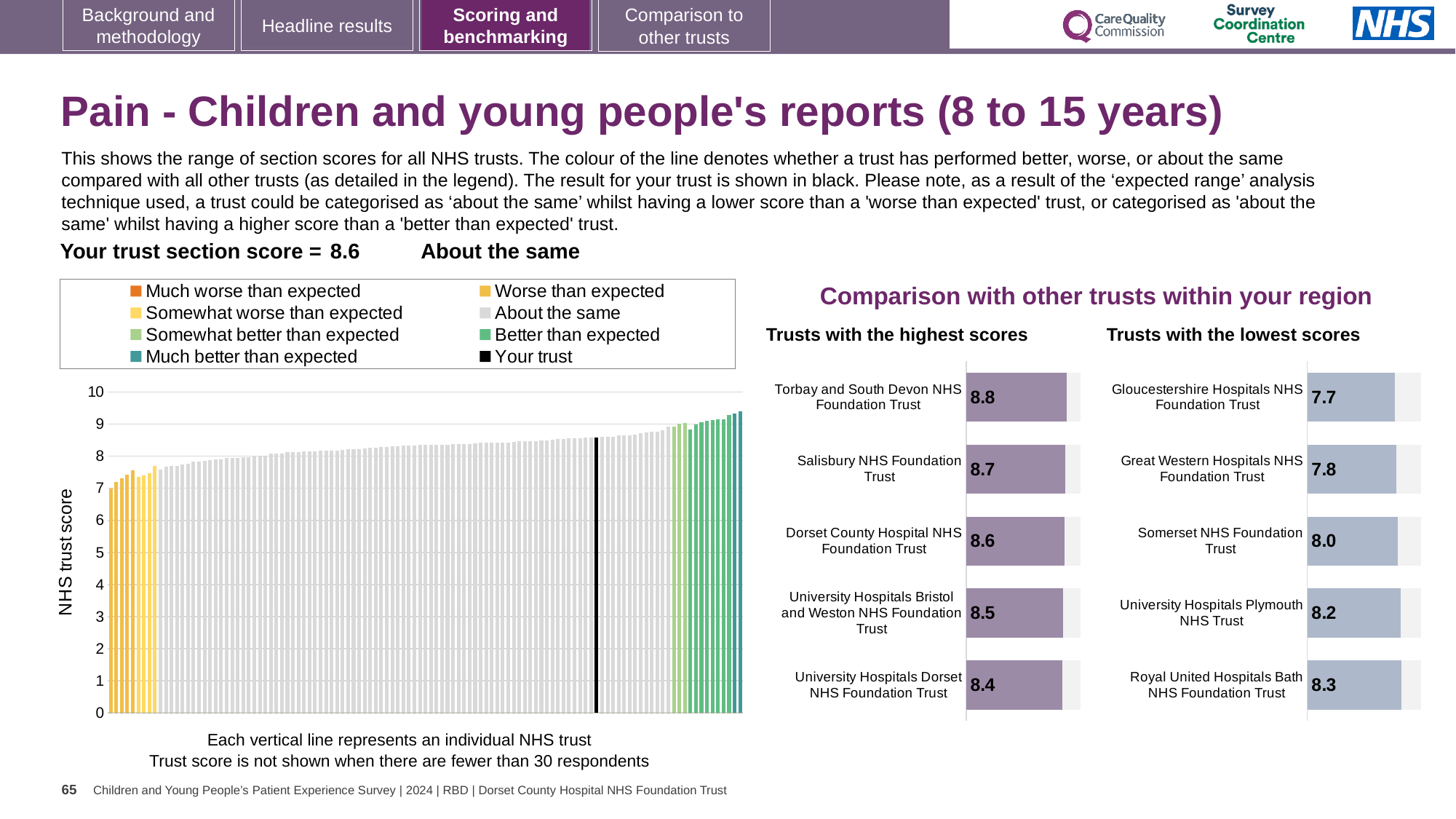
How many trusts are shown in the 'Trusts with the lowest scores' chart? 5 In the 'Trusts with the highest scores' chart, what is the difference between the scores of Torbay and South Devon NHS Foundation Trust and University Hospitals Dorset NHS Foundation Trust? 0.4 In the 'Trusts with the lowest scores' chart, which trust has the lowest score? Gloucestershire Hospitals NHS Foundation Trust In the 'Trusts with the lowest scores' chart, which has the larger score: Somerset NHS Foundation Trust or Great Western Hospitals NHS Foundation Trust? Somerset NHS Foundation Trust In the 'Trusts with the lowest scores' chart, what is the score for University Hospitals Plymouth NHS Trust? 8.2 How many entries does the legend of the main chart on the left list? 8 In the 'Trusts with the highest scores' chart, which trust has the highest score? Torbay and South Devon NHS Foundation Trust In the main chart on the left, is the value for the black 'Your trust' bar greater or less than 8? greater What is the y-axis label of the main chart on the left? NHS trust score In the 'Trusts with the highest scores' chart, what is the score for Torbay and South Devon NHS Foundation Trust? 8.8 In the 'Trusts with the highest scores' chart, what is the score for University Hospitals Bristol and Weston NHS Foundation Trust? 8.5 In the 'Trusts with the lowest scores' chart, what is the score for Gloucestershire Hospitals NHS Foundation Trust? 7.7